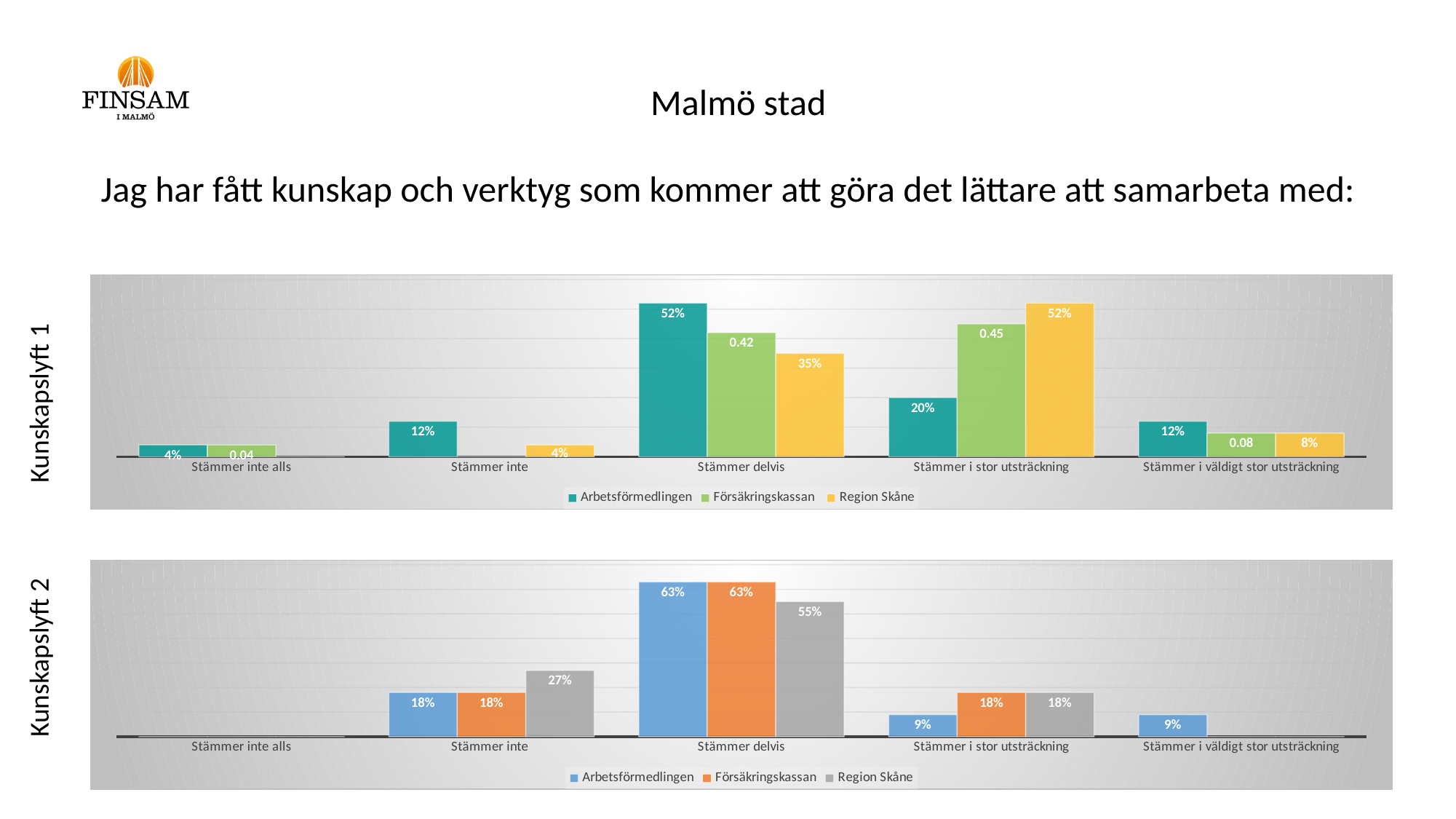
In the Kunskapslyft 2 chart, what is the value for Region Skåne at 'Stämmer delvis'? 55% What kind of chart is the Kunskapslyft 1 chart? Bar chart In the Kunskapslyft 2 chart, what is the difference between Försäkringskassan and Arbetsförmedlingen at 'Stämmer i stor utsträckning'? 9% In the Kunskapslyft 1 chart, what is the value for Arbetsförmedlingen at 'Stämmer delvis'? 52% In the Kunskapslyft 1 chart, what is the difference between Arbetsförmedlingen and Region Skåne at 'Stämmer delvis'? 17% In the Kunskapslyft 2 chart, what is the value for Region Skåne at 'Stämmer inte'? 27% In the Kunskapslyft 1 chart, which category has the highest value for Arbetsförmedlingen? Stämmer delvis In the Kunskapslyft 2 chart, which category has the lowest value for Arbetsförmedlingen among those with a labelled bar? Stämmer i stor utsträckning and Stämmer i väldigt stor utsträckning (both 9%) In the Kunskapslyft 1 chart, which is larger at 'Stämmer i stor utsträckning': Arbetsförmedlingen or Region Skåne? Region Skåne In the Kunskapslyft 1 chart, what is the value for Försäkringskassan at 'Stämmer i stor utsträckning'? 0.45 How many series does the legend of the Kunskapslyft 2 chart list? 3 In the Kunskapslyft 1 chart, what is the value for Region Skåne at 'Stämmer i stor utsträckning'? 52%